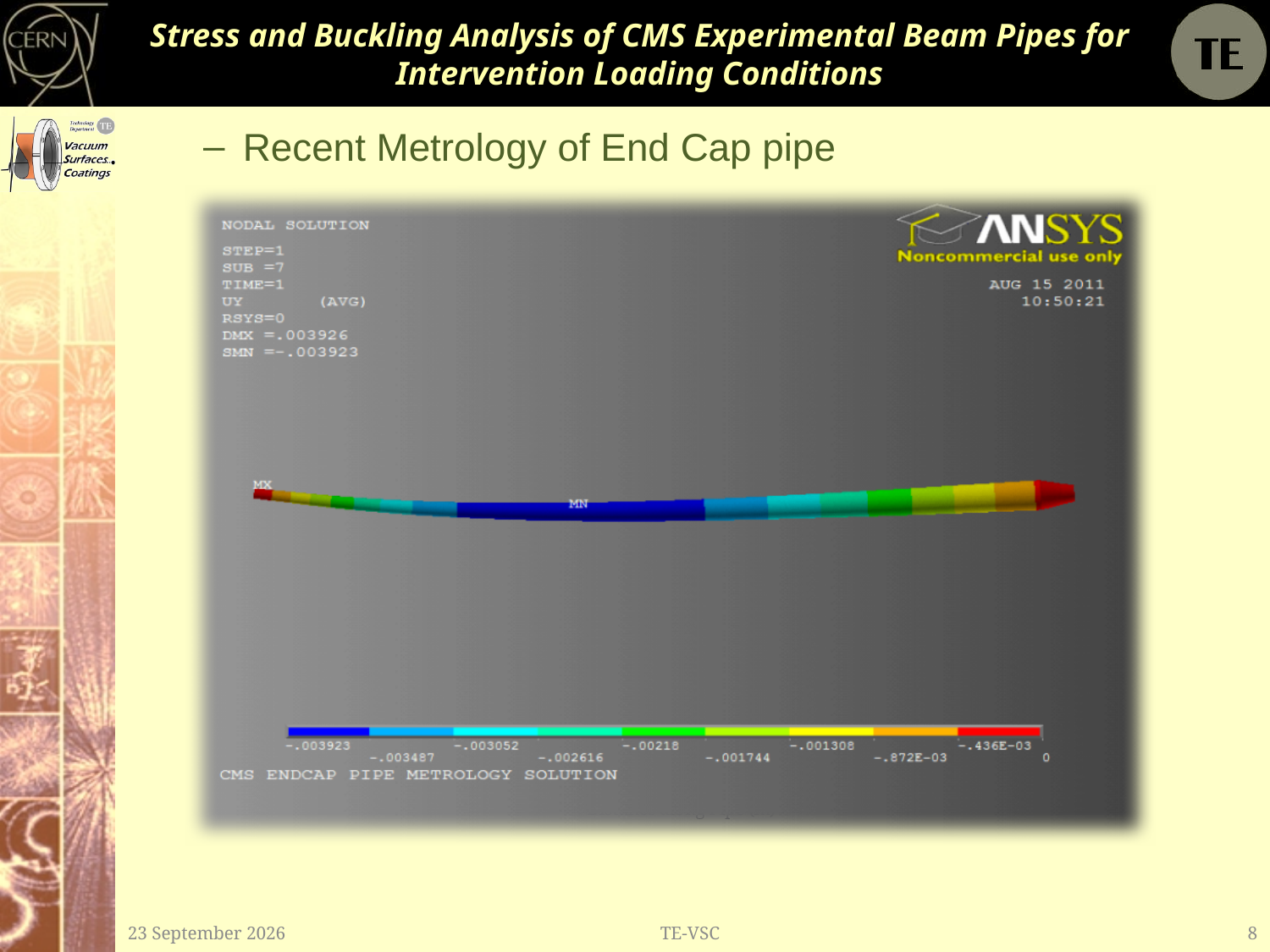
What date is printed on the ANSYS plot? AUG 15 2011 What is the highest value shown on the colour scale at the bottom of the plot? 0 What is the DMX value printed in the top-left text block of the ANSYS plot? .003926 What is the SUB value listed in the nodal solution text block? 7 Which colour on the scale corresponds to the value 0? Red How many colour bands does the colour scale at the bottom of the plot contain? 9 Which quantity is plotted in the nodal solution, according to the text block? UY (AVG) Which colour on the scale corresponds to the most negative UY values? Dark blue What caption is printed at the bottom of the ANSYS plot? CMS ENDCAP PIPE METROLOGY SOLUTION What is the SMN value printed in the top-left text block of the ANSYS plot? -.003923 What is the lowest value shown on the colour scale at the bottom of the plot? -.003923 What is the STEP value listed in the nodal solution text block? 1